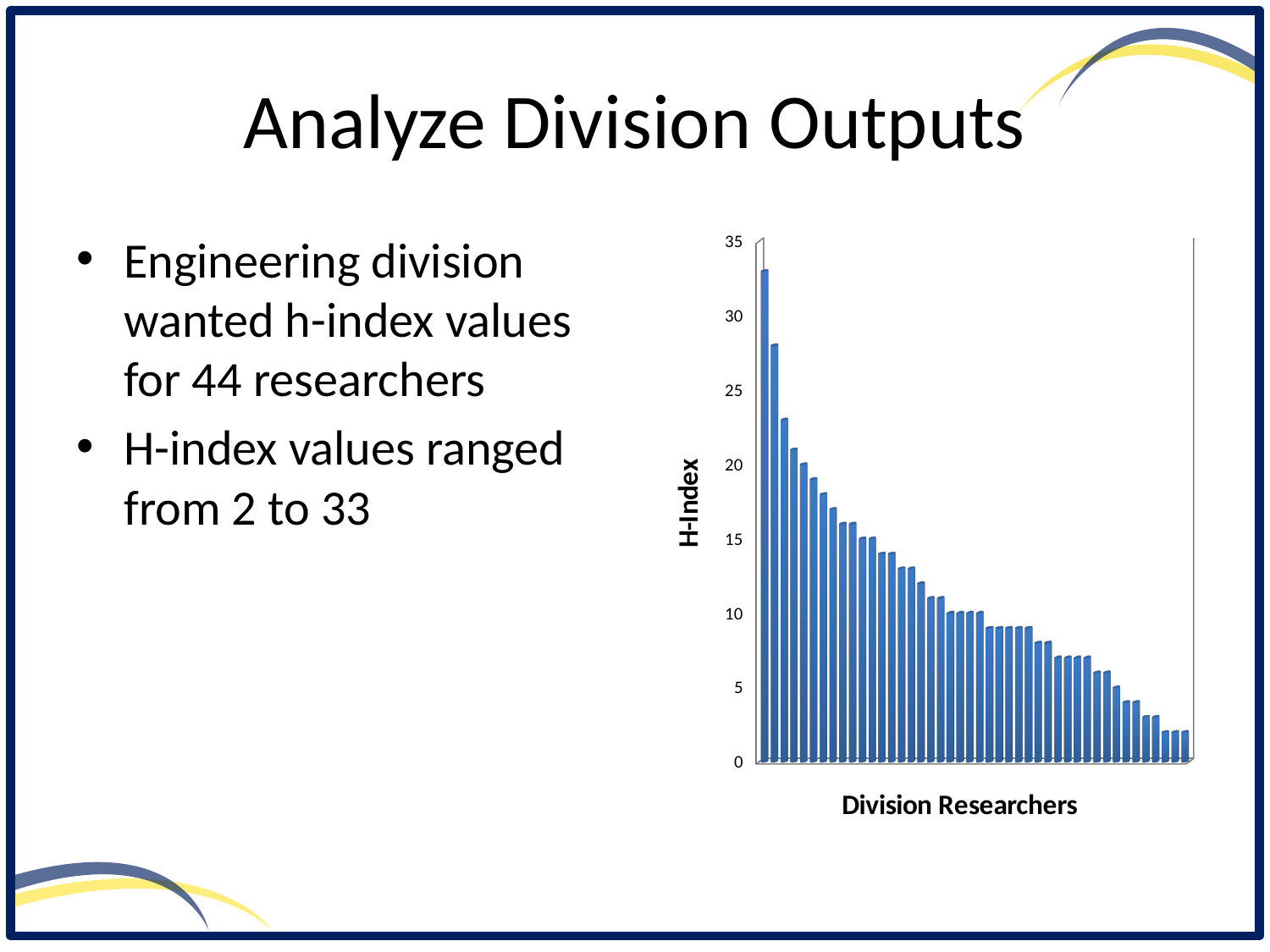
Which bar is taller, the leftmost bar or the rightmost bar? the leftmost bar Is the value for the leftmost (tallest) bar greater or less than 30? greater What is the title of the horizontal axis of the chart? Division Researchers Is the value for the shortest bar greater or less than 5? less What kind of chart is shown on the slide? bar chart Is the value for the rightmost bar greater or less than 5? less Do the bar values rise or fall from left to right along the x axis? fall How many researchers are plotted in the chart? 44 What is the title of the vertical axis of the chart? H-Index